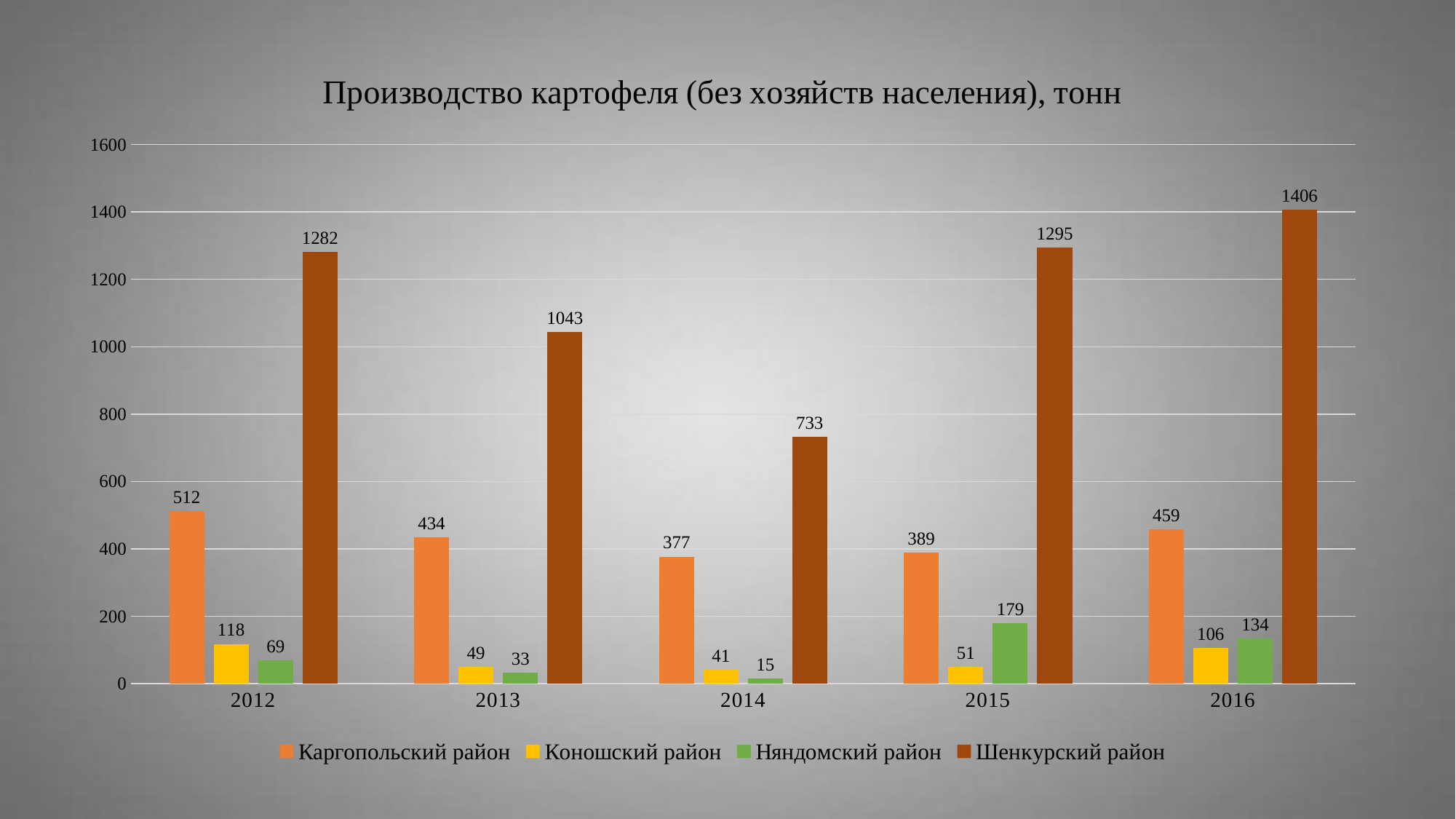
What is the value for Коношский район in 2012? 118 What is the difference between the Шенкурский район values in 2016 and 2015? 111 What is the title of the chart? Производство картофеля (без хозяйств населения), тонн Which is larger in 2015: Коношский район or Няндомский район? Няндомский район How many years are shown on the x axis? 5 In which year is the value for Каргопольский район highest? 2012 What is the value for Шенкурский район in 2016? 1406 What is the value for Няндомский район in 2014? 15 How many series does the legend list? 4 In which year is the value for Шенкурский район lowest? 2014 What kind of chart is this? bar chart Does the value for Каргопольский район rise or fall from 2012 to 2014? fall